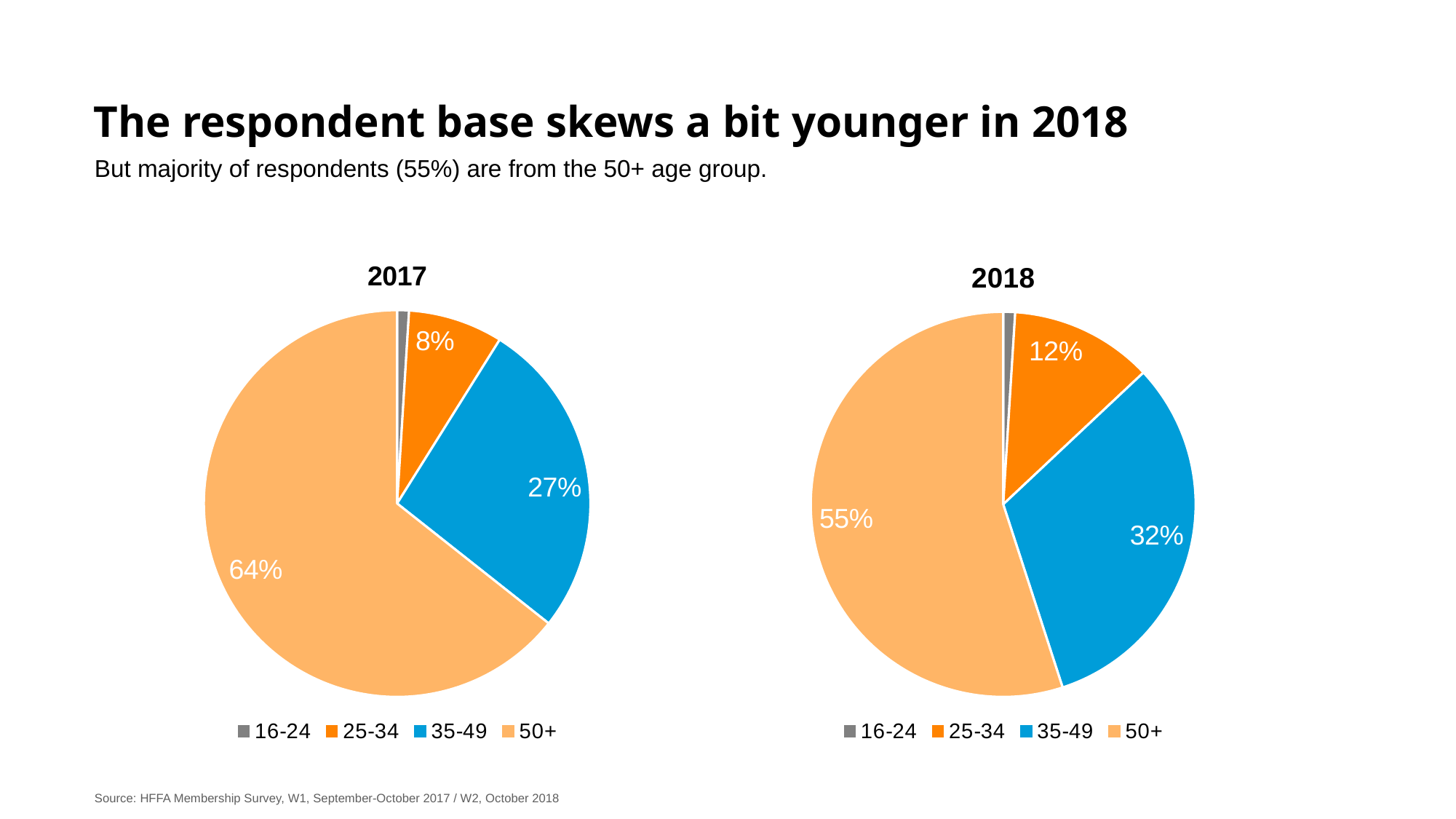
What kind of chart is used to show the 2018 age distribution? Pie chart What is the difference between the 50+ share in 2017 and the 50+ share in 2018? 9 percentage points Is the 25-34 share larger in the 2017 pie chart or the 2018 pie chart? 2018 In the 2018 pie chart, what share of respondents are in the 35-49 age group? 32% In the 2017 pie chart, what share of respondents are in the 50+ age group? 64% In the 2018 pie chart, what share of respondents are in the 50+ age group? 55% What colour represents the 35-49 age group in both pie charts? Blue What is the difference between the 35-49 share and the 25-34 share in the 2018 pie chart? 20 percentage points In the 2017 pie chart, what share of respondents are in the 25-34 age group? 8% In the 2018 pie chart, which age group has the largest share? 50+ In the 2017 pie chart, which age group has the smallest share? 16-24 How many age groups does the legend of the 2017 pie chart list? 4